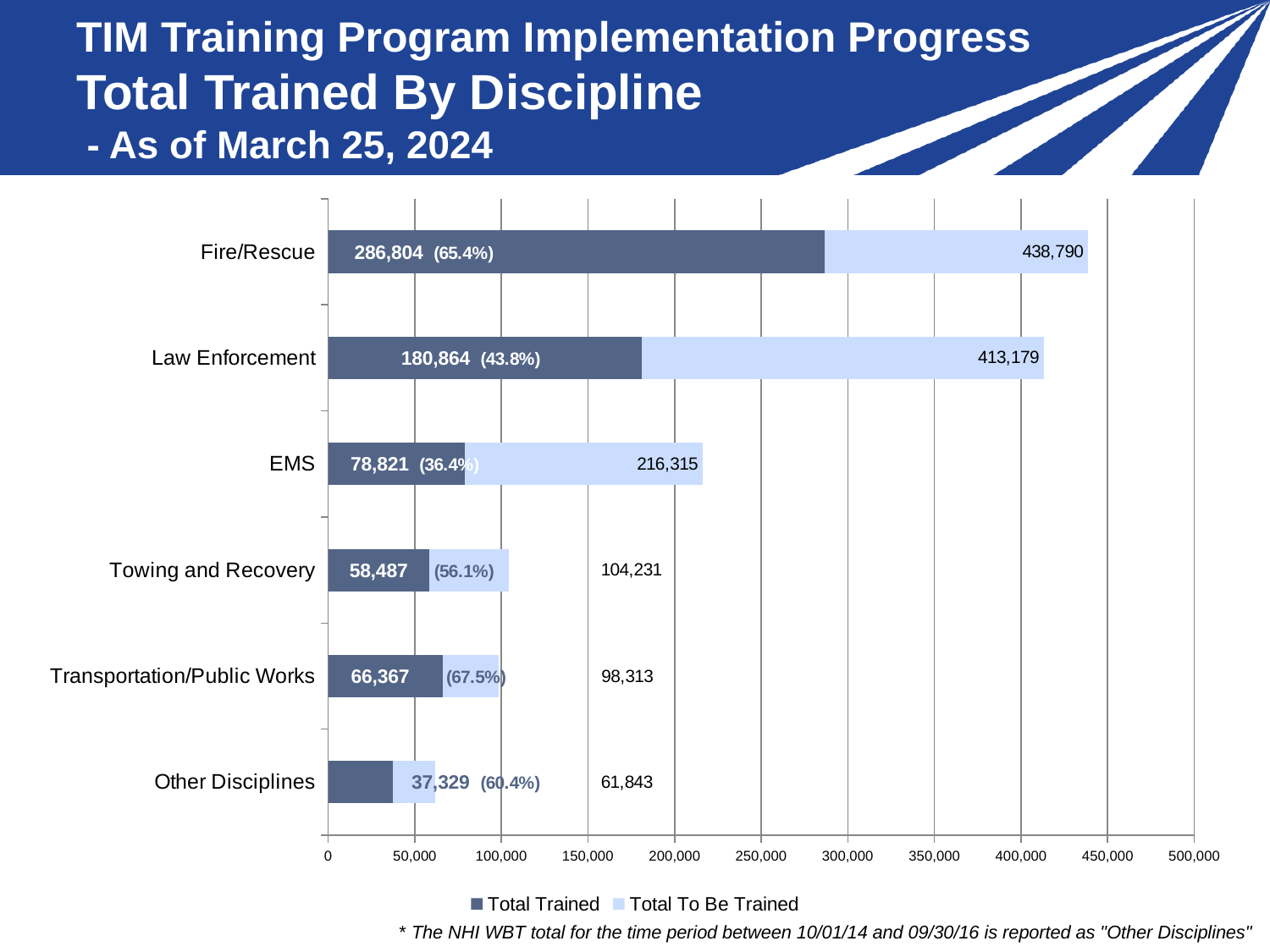
What percentage is shown next to the Law Enforcement Total Trained value? 43.8% Which has a larger Total Trained value, Towing and Recovery or Transportation/Public Works? Transportation/Public Works What kind of chart is shown on the slide? Bar chart How many series does the legend list? 2 What is the Total Trained value for Fire/Rescue? 286,804 What is the total value printed at the end of the EMS bar? 216,315 Which discipline has the highest Total Trained value? Fire/Rescue What is the Total Trained value for Other Disciplines? 37,329 What is the difference between the Total Trained values for Fire/Rescue and Law Enforcement? 105,940 Is the total value for Law Enforcement greater or less than 400,000? greater Which discipline has the lowest total value printed at the end of its bar? Other Disciplines How many disciplines are shown on the chart? 6